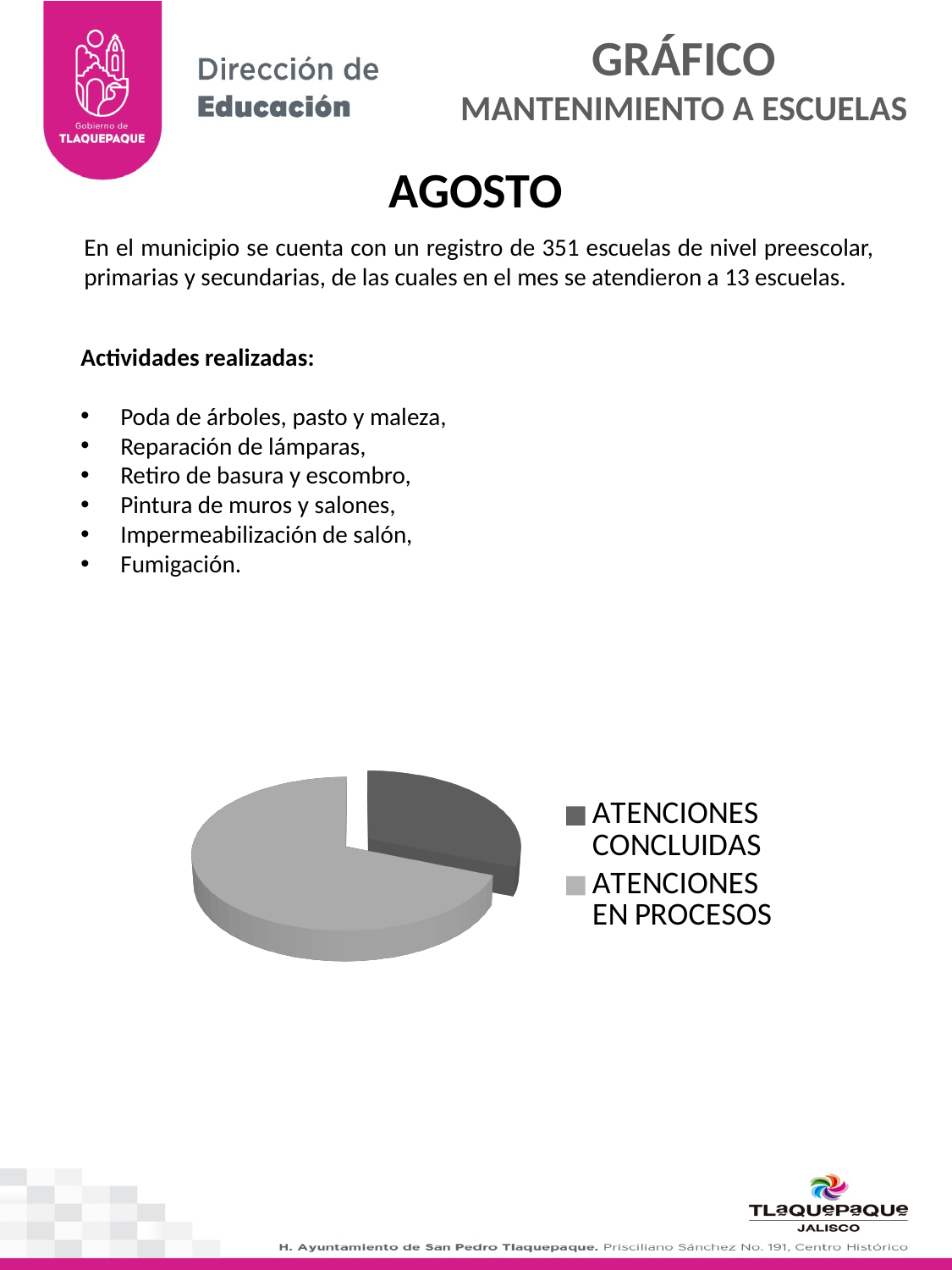
How many slices does the pie chart have? 2 Which slice of the pie chart is the smallest? ATENCIONES CONCLUIDAS How many entries does the legend of the pie chart list? 2 Which is larger in the pie chart, ATENCIONES CONCLUIDAS or ATENCIONES EN PROCESOS? ATENCIONES EN PROCESOS What kind of chart is shown on the slide? pie chart Which slice of the pie chart is pulled out (exploded) from the rest of the pie? ATENCIONES CONCLUIDAS Which legend entry is shown in dark gray in the pie chart? ATENCIONES CONCLUIDAS Which slice of the pie chart is the largest? ATENCIONES EN PROCESOS